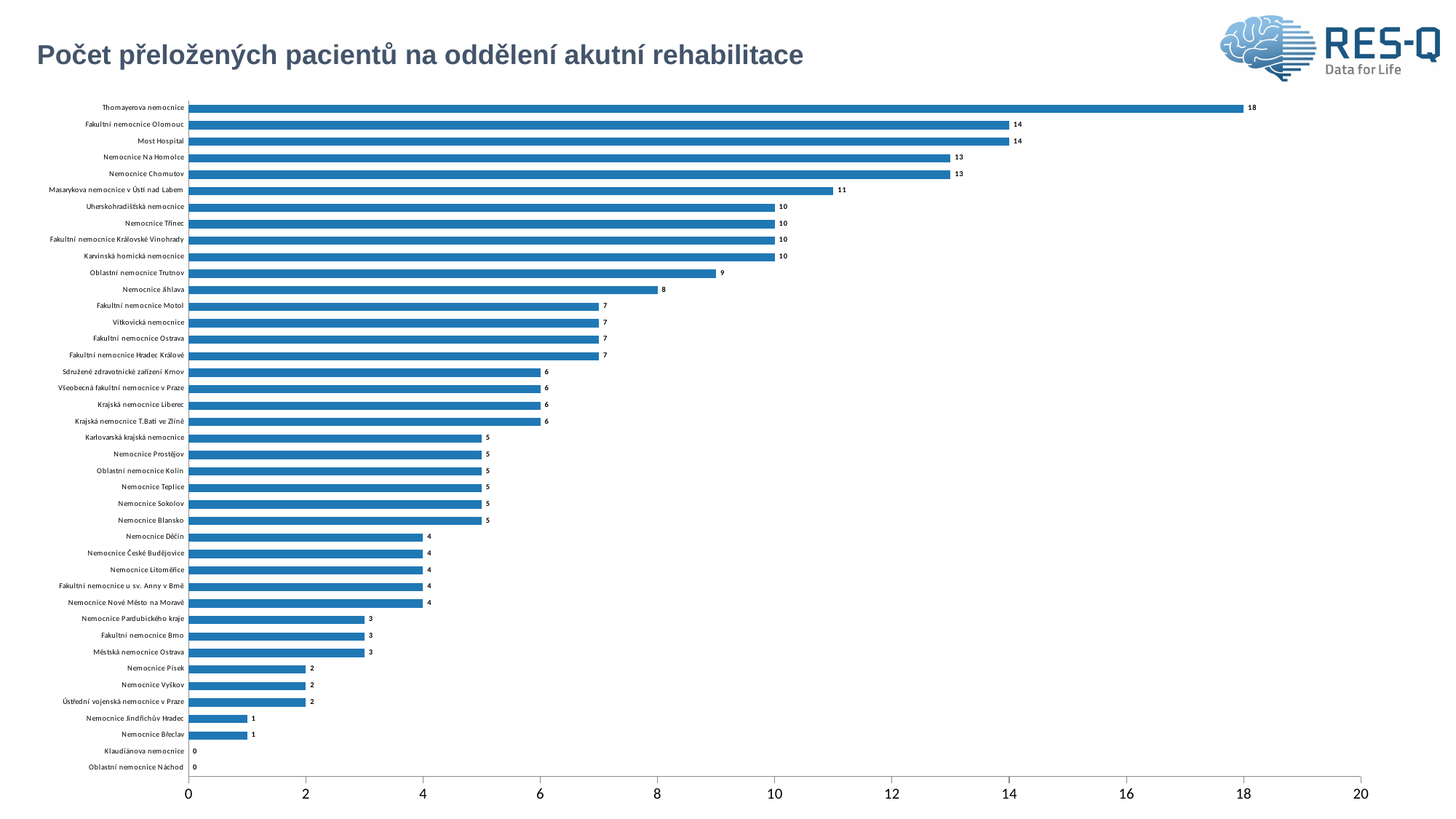
What is the value for Masarykova nemocnice v Ústí nad Labem? 11 What is the value for Fakultní nemocnice Brno? 3 What is the value for Nemocnice Jihlava? 8 Which hospital has the highest number of transferred patients? Thomayerova nemocnice What is the title of the chart? Počet přeložených pacientů na oddělení akutní rehabilitace How many hospitals are shown on the chart? 41 What kind of chart is shown on the slide? Bar chart What is the value for Thomayerova nemocnice? 18 What is the difference between the values for Thomayerova nemocnice and Fakultní nemocnice Olomouc? 4 Which is larger, the value for Nemocnice Třinec or the value for Fakultní nemocnice Motol? Nemocnice Třinec Is the value for Most Hospital greater or less than 12? greater What is the difference between the values for Nemocnice Na Homolce and Oblastní nemocnice Trutnov? 4